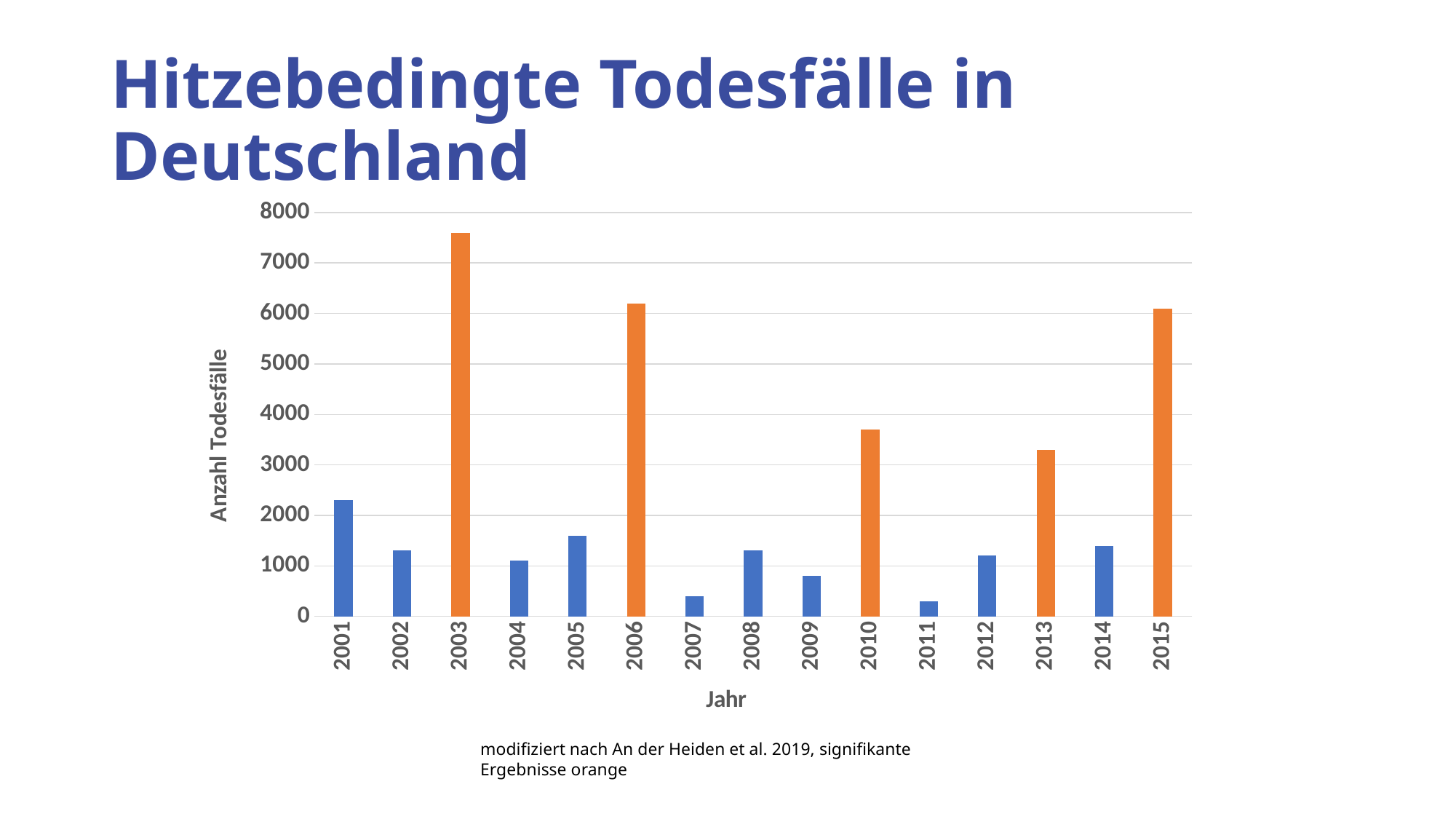
Is the value for 2006 greater or less than 6000? greater How many years are shown on the x axis of the chart? 15 According to the note below the chart, what do the orange bars indicate? signifikante Ergebnisse Is the value for 2010 greater or less than 4000? less What kind of chart is shown on the slide? bar chart Which year has the larger value, 2003 or 2006? 2003 What is the label of the y axis of the chart? Anzahl Todesfälle Is the value for 2007 greater or less than 1000? less Which year has the highest number of heat-related deaths in the chart? 2003